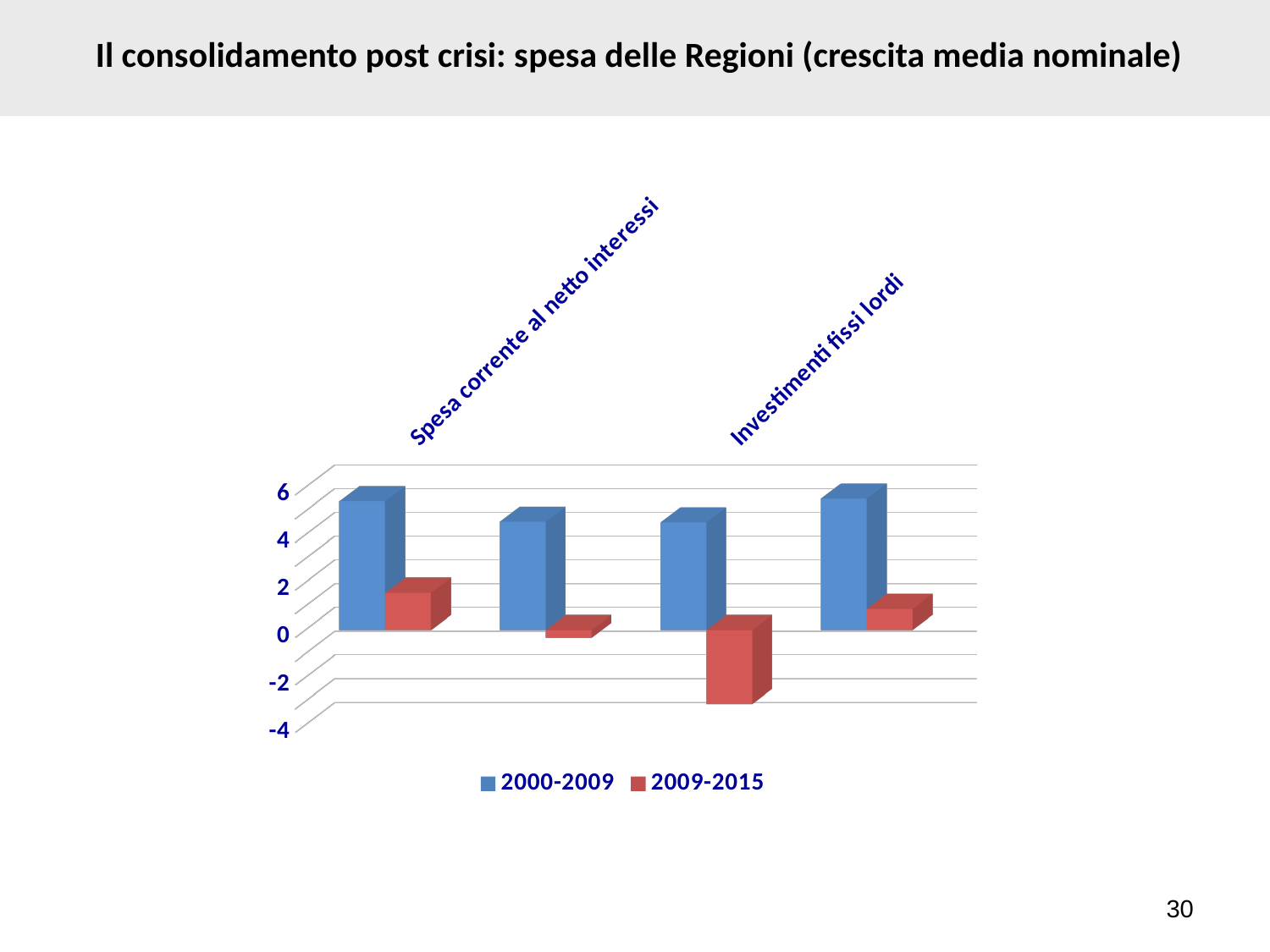
In each group of bars, which series has the higher value, 2000-2009 or 2009-2015? 2000-2009 Is the tallest 2000-2009 bar greater or less than 4? greater What is the title of the slide containing the chart? Il consolidamento post crisi: spesa delle Regioni (crescita media nominale) What are the two series named in the legend? 2000-2009 and 2009-2015 Is the value of every 2009-2015 bar greater or less than 4? less How many groups of bars are plotted in the chart? 4 How many series does the legend list? 2 Is the value of every 2000-2009 bar greater or less than 2? greater How many of the 2009-2015 bars fall below zero? 2 What kind of chart is shown on the slide? bar chart